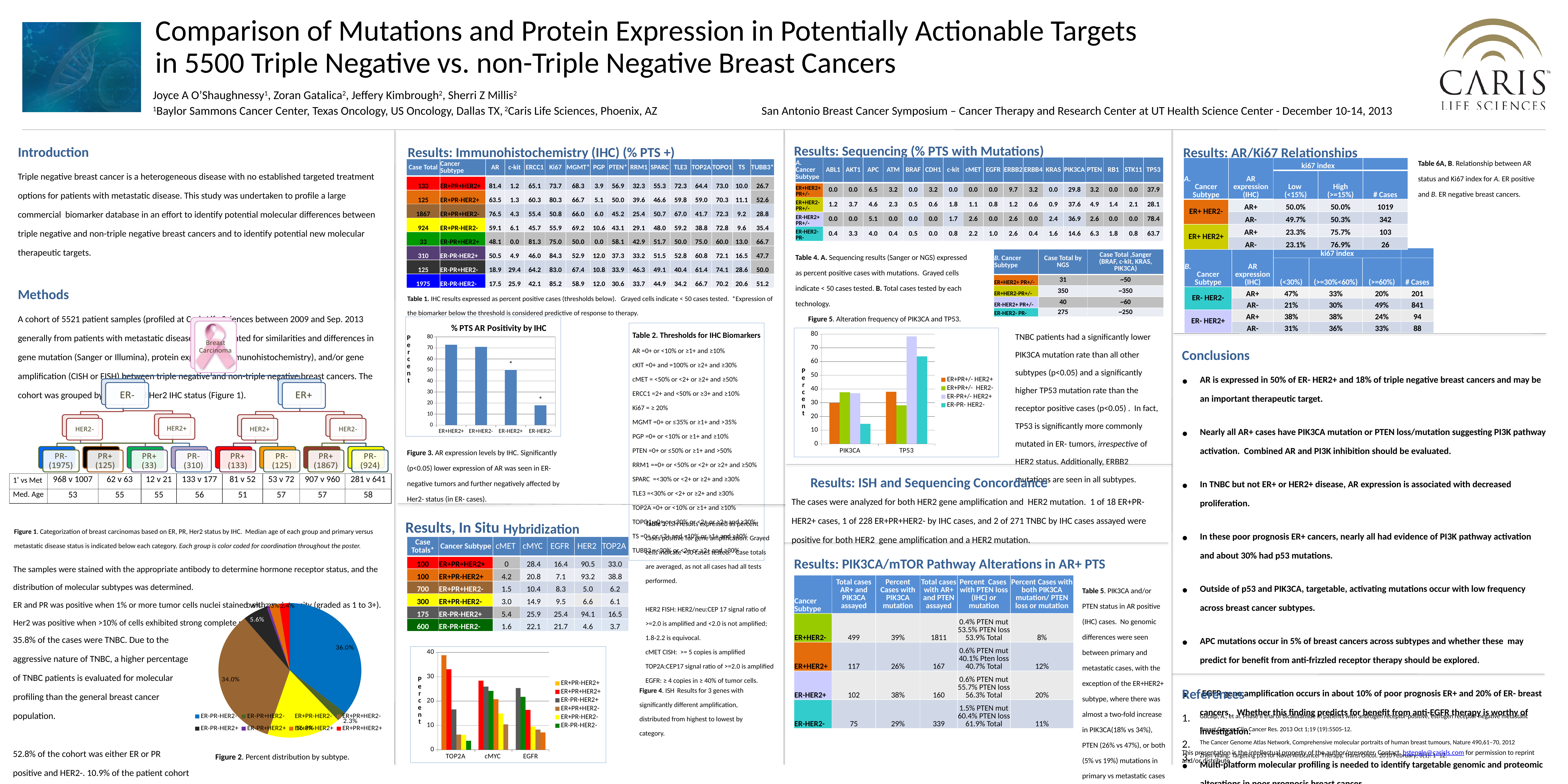
In the Figure 5 chart of alteration frequency of PIK3CA and TP53, which subtype has the highest TP53 value? ER-PR+/- HER2+ In the Figure 5 chart of alteration frequency of PIK3CA and TP53, which subtype has the lowest PIK3CA value? ER-PR-HER2- In the Figure 2 pie chart of percent distribution by subtype, what percentage is shown on the largest slice? 36.0% In the Figure 5 chart of alteration frequency of PIK3CA and TP53, is the TP53 value for ER-PR+/- HER2+ greater or less than 70? greater How many subtype categories are plotted in the '% PTS AR Positivity by IHC' chart (Figure 3)? 4 In the '% PTS AR Positivity by IHC' chart (Figure 3), which subtype has the lowest AR positivity? ER-HER2- In the Figure 4 ISH results chart, which subtype has the highest TOP2A value? ER+PR-HER2+ How many series does the legend list in the Figure 4 ISH results chart (TOP2A, cMYC, EGFR)? 6 What kind of chart is the '% PTS AR Positivity by IHC' chart (Figure 3)? bar chart In the '% PTS AR Positivity by IHC' chart (Figure 3), do the bar values rise or fall from left to right? fall How many series does the legend list in the Figure 5 chart of alteration frequency of PIK3CA and TP53? 4